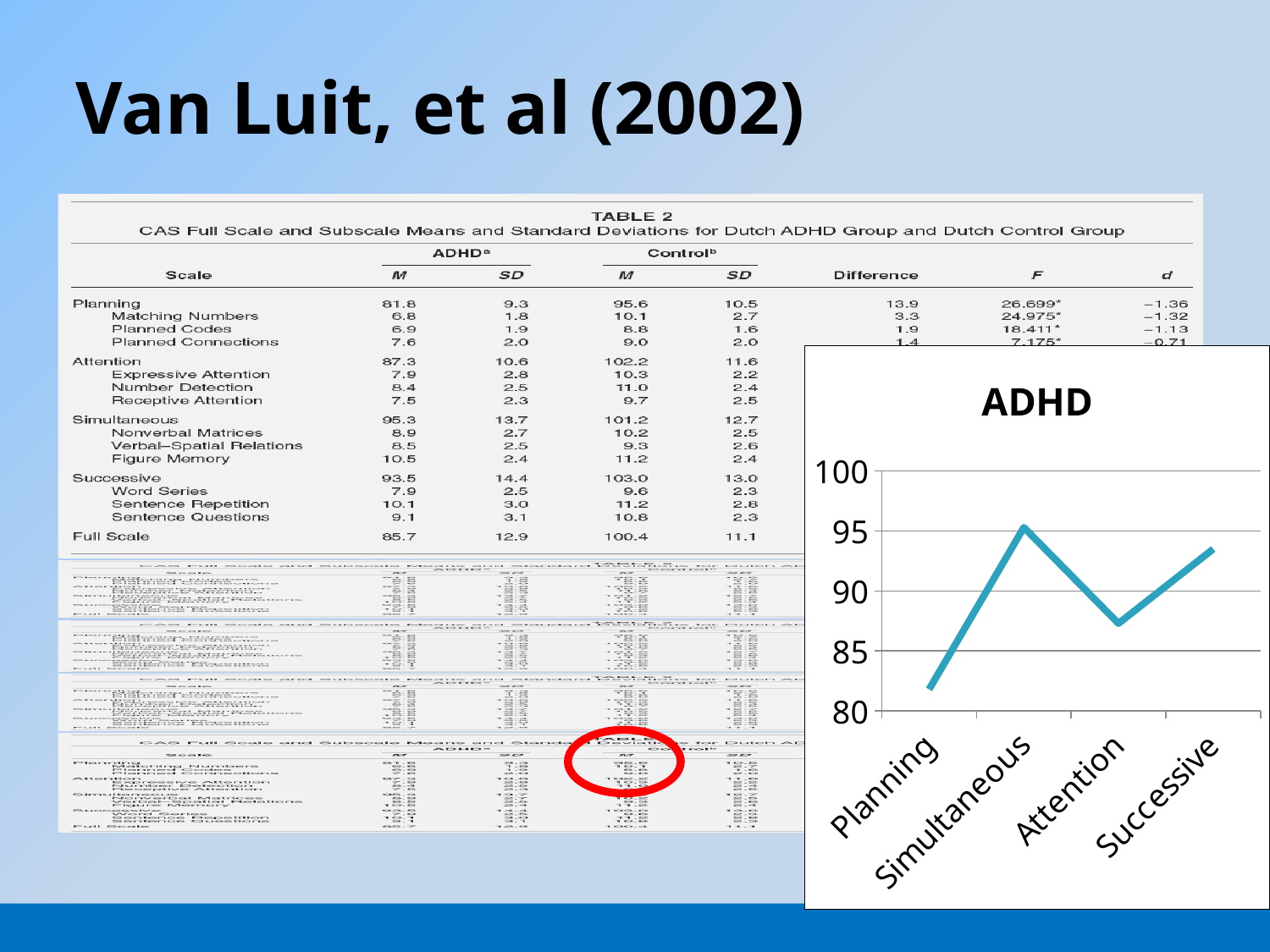
In the ADHD chart, does the line rise or fall from Simultaneous to Attention? fall In the ADHD chart, is the value for Simultaneous greater or less than 90? greater In the ADHD chart, which is larger, the value for Attention or the value for Successive? Successive In the ADHD chart, is the value for Planning greater or less than 85? less What is the title of the chart on the slide? ADHD In the ADHD chart, is the value for Successive greater or less than 90? greater What are the lowest and highest values shown on the y axis of the ADHD chart? 80 and 100 Which category has the lowest value in the ADHD chart? Planning Which category has the highest value in the ADHD chart? Simultaneous How many categories are plotted along the x axis of the ADHD chart? 4 What kind of chart is shown on the slide? line chart